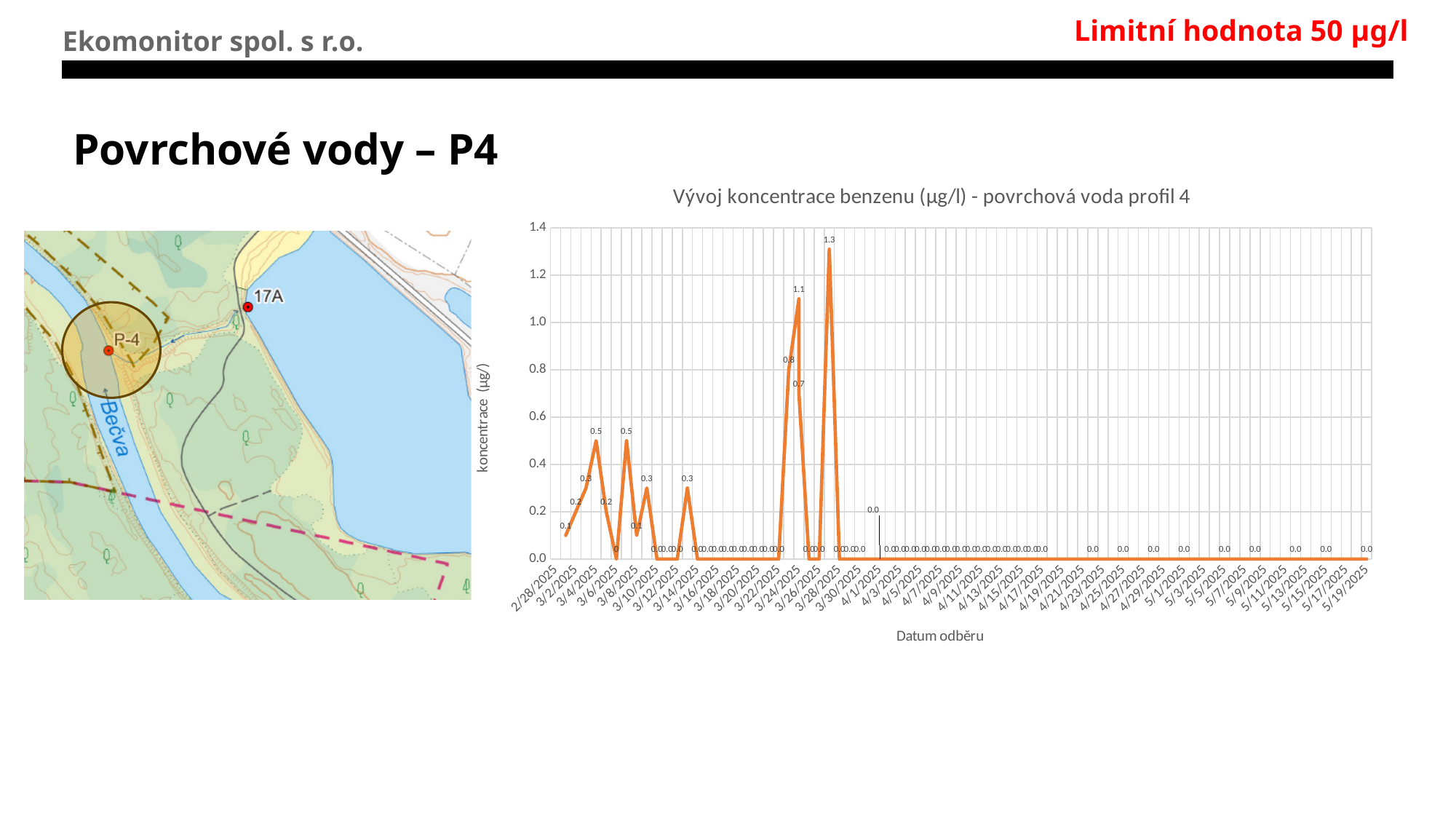
What is the difference between the two highest labelled peaks, 1.3 and 1.1? 0.2 What kind of chart is shown on the slide? line chart What is the maximum value shown on the vertical axis? 1.4 What is the last date shown on the horizontal axis? 5/19/2025 Which is larger, the peak labelled 1.3 or the peak labelled 1.1? 1.3 What is the highest benzene concentration value labelled on the chart? 1.3 What is the lowest value labelled on the chart? 0.0 What is the label of the vertical axis? koncentrace (µg/l) Is the highest peak on the chart greater or less than 1.0? greater What is the concentration value at the first date, 2/28/2025? 0.1 What is the title of the chart? Vývoj koncentrace benzenu (µg/l) - povrchová voda profil 4